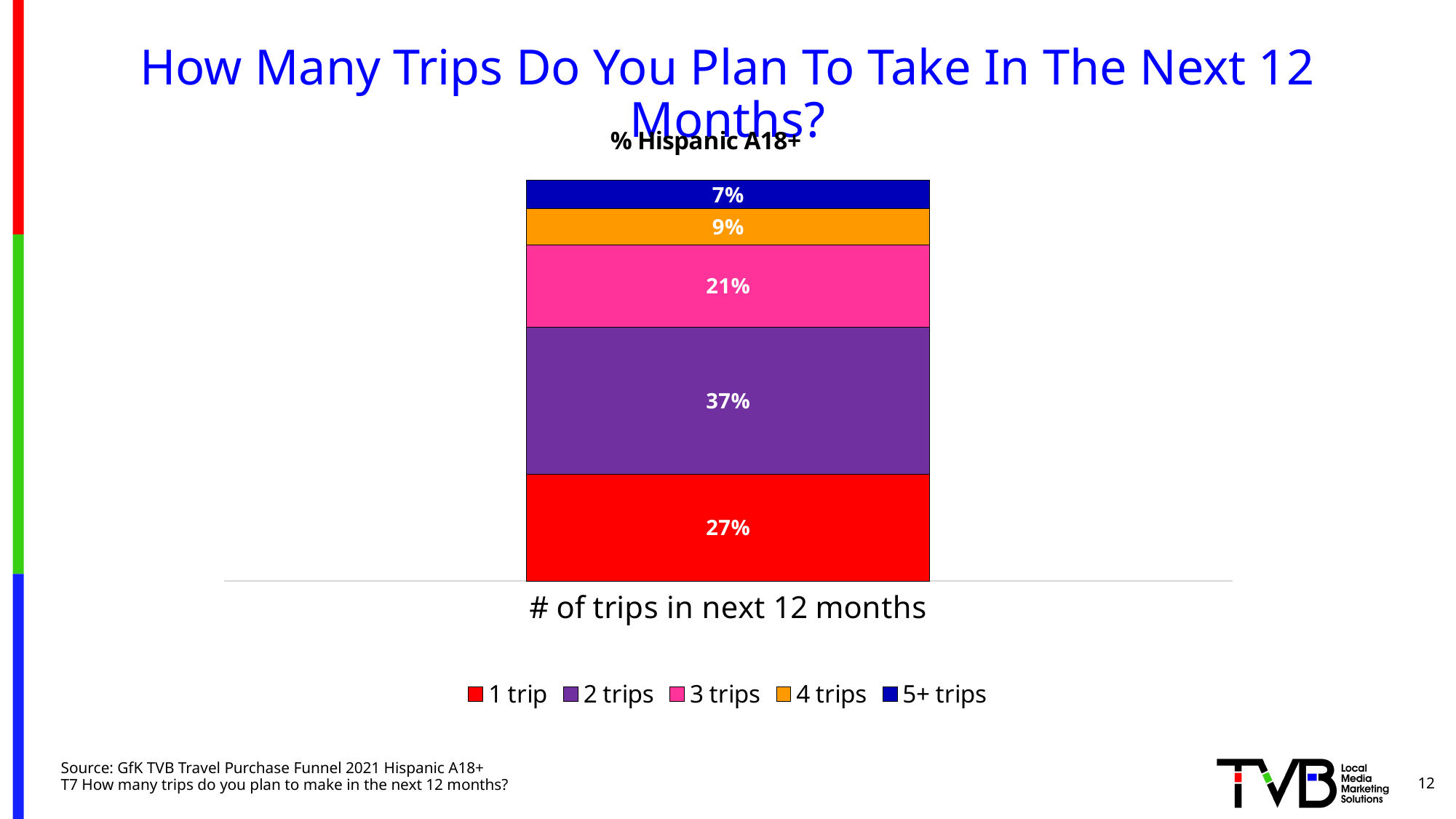
What is the total of all segments in the stacked bar? 101% Which number of trips has the largest share of respondents? 2 trips What colour represents the 4 trips segment in the chart? Orange What is the difference in percentage points between the 2 trips and 1 trip segments? 10 What percentage of Hispanic adults 18+ plan to take 2 trips in the next 12 months? 37% How many series does the legend list? 5 What percentage plan to take 5+ trips in the next 12 months? 7% Which number of trips has the smallest share of respondents? 5+ trips What percentage plan to take 1 trip in the next 12 months? 27% What percentage plan to take 3 trips in the next 12 months? 21% What kind of chart is shown on the slide? Stacked bar chart Which is larger, the share planning 3 trips or the share planning 4 trips? 3 trips